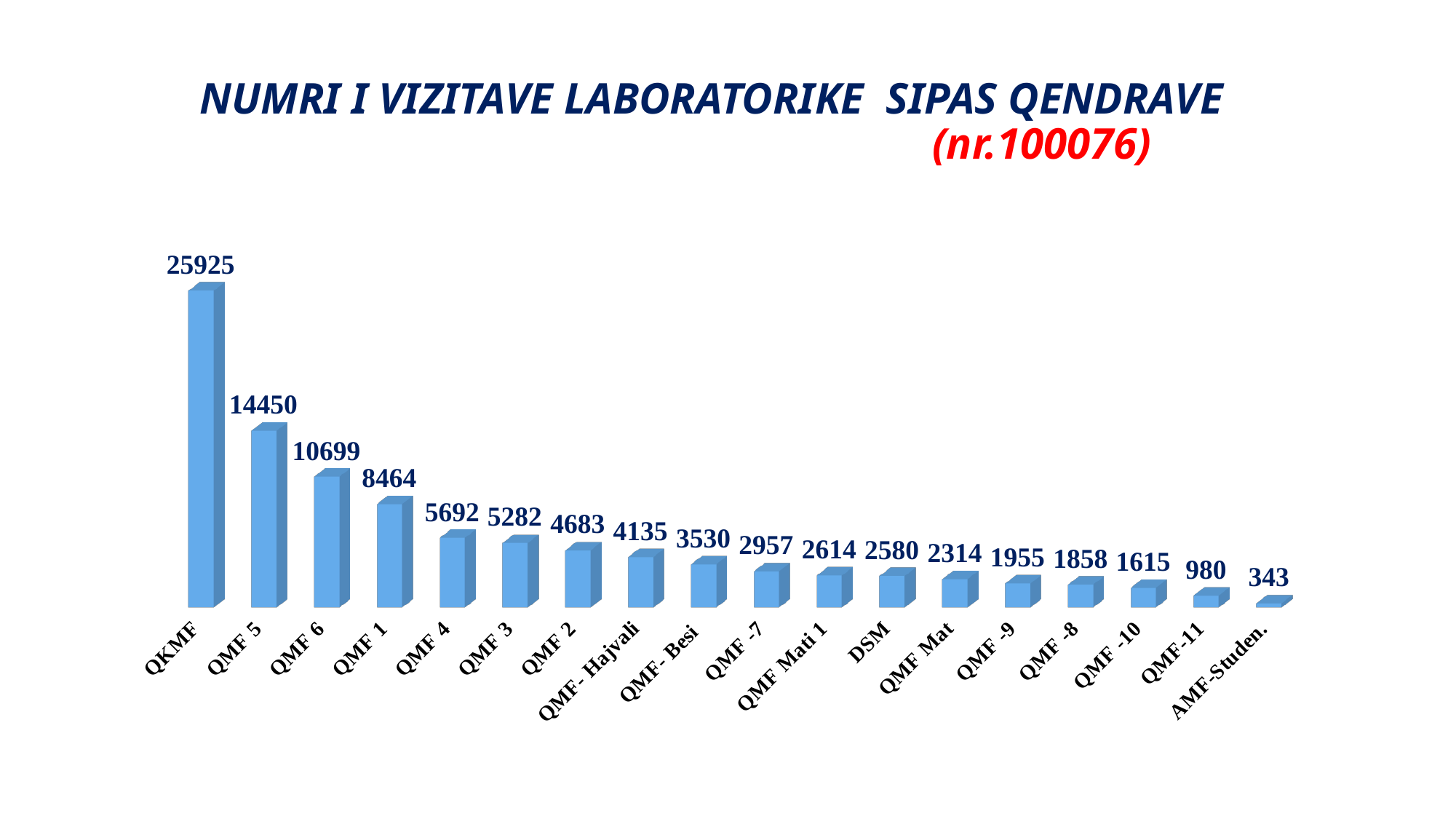
Which has a larger value, QMF 4 or QMF 2? QMF 4 What is the difference between the values for QKMF and QMF 5? 11475 Which category has the lowest value? AMF-Studen. What is the difference between the values for QMF 6 and QMF 1? 2235 What is the value for QMF- Hajvali? 4135 How many categories are shown on the chart? 18 Which category has the highest value? QKMF What kind of chart is shown on the slide? Bar chart What is the value for QMF-11? 980 Do the values rise or fall from left to right along the x axis? Fall What is the value for QKMF? 25925 What is the value for DSM? 2580